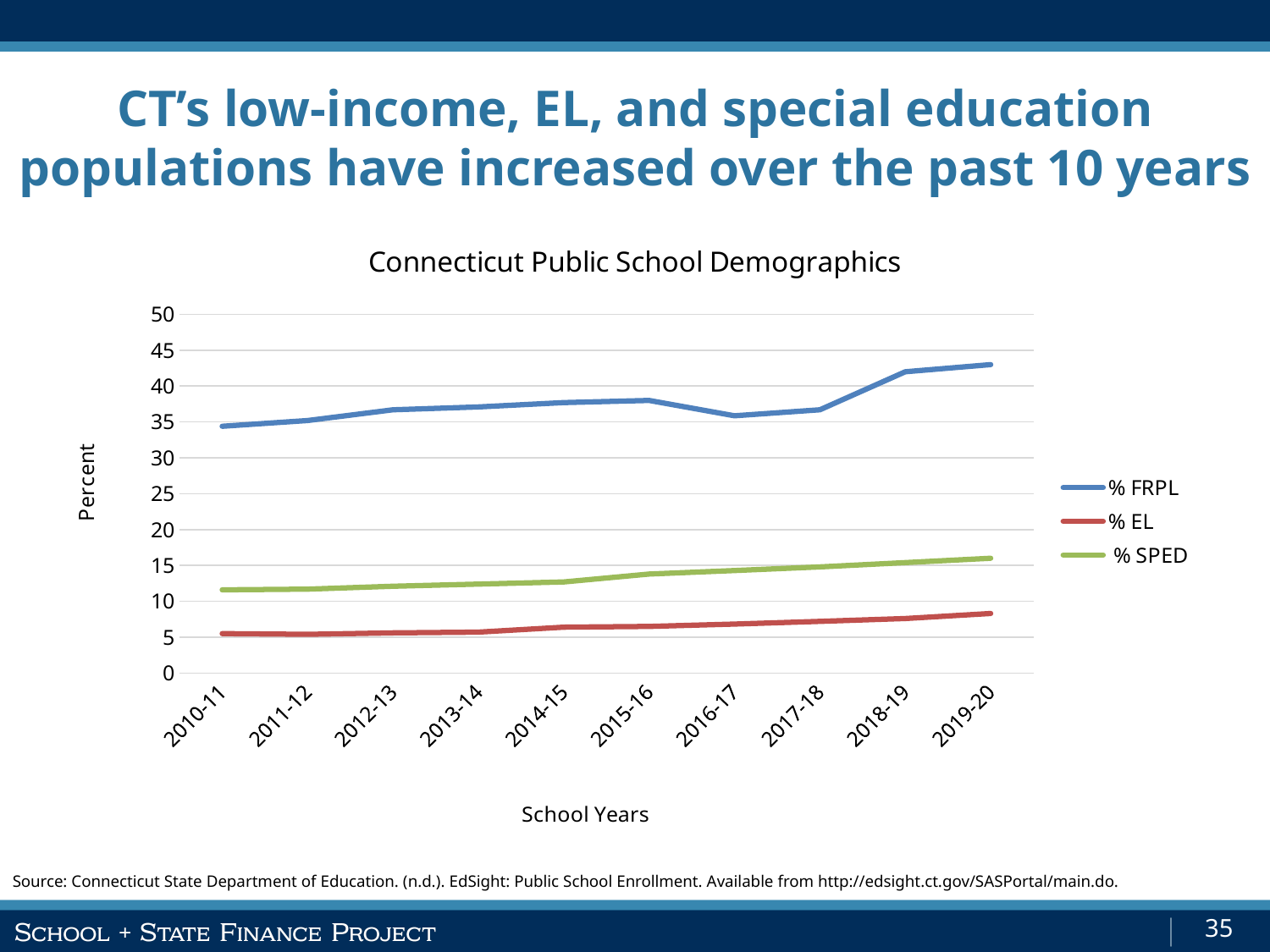
Is the value for % EL in 2010-11 greater or less than 10? less Which series has the lowest values across all school years? % EL Which series has the highest values across all school years? % FRPL Is the value for % SPED in 2010-11 greater or less than 10? greater Does the % EL line rise or fall from 2010-11 to 2019-20? rise What is the title of the chart? Connecticut Public School Demographics In 2015-16, which is larger, % SPED or % EL? % SPED Is the value for % FRPL in 2019-20 greater or less than 40? greater How many school years are plotted along the x axis? 10 How many series does the legend list? 3 What kind of chart is shown on the slide? line chart What is the label on the y axis? Percent